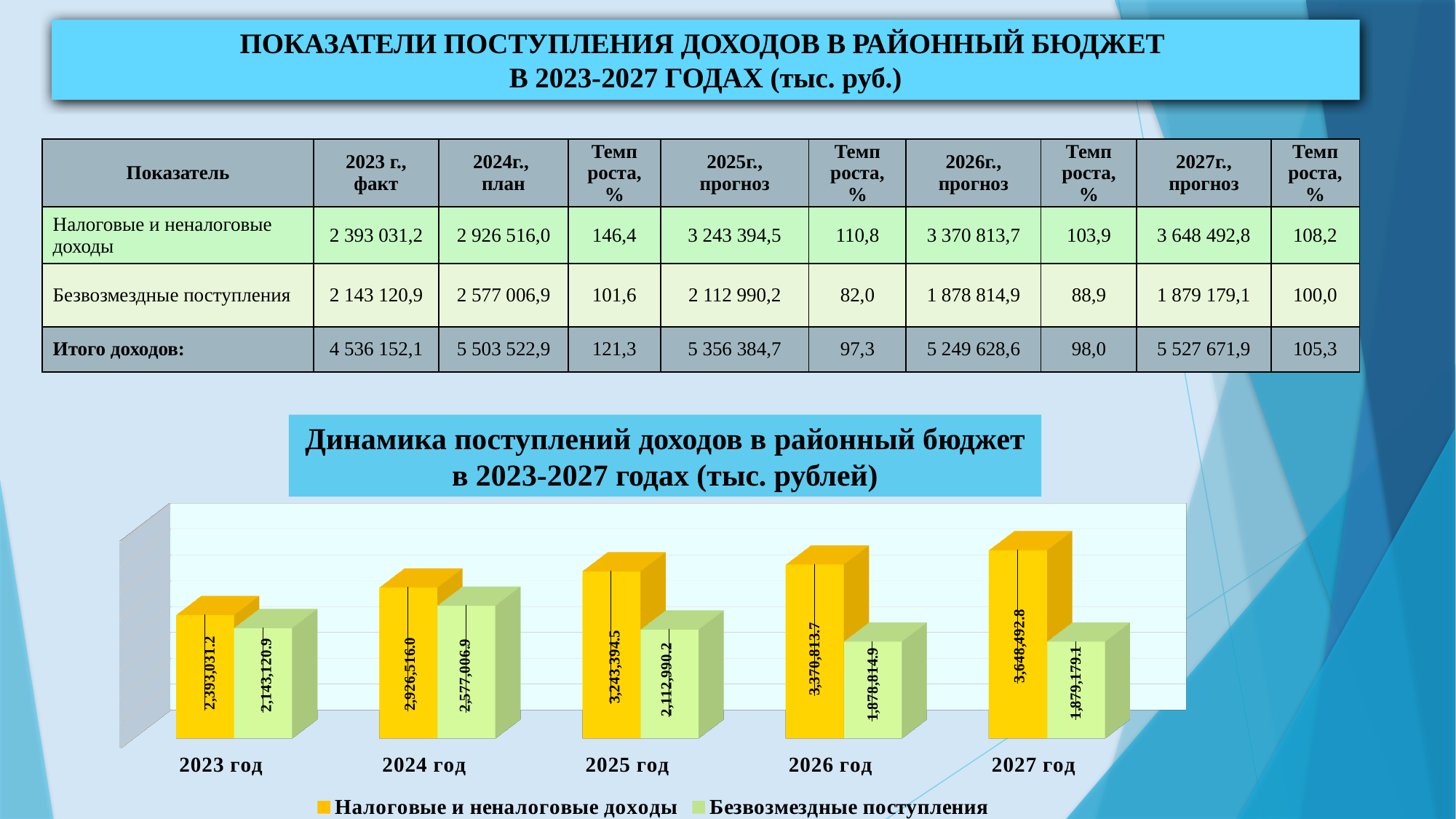
What is the value of Безвозмездные поступления for 2026 год in the chart? 1,878,814.9 What type of chart is shown on the slide? bar chart Does Налоговые и неналоговые доходы rise or fall from 2023 год to 2027 год in the chart? rise In which year is Налоговые и неналоговые доходы highest in the chart? 2027 год What colour are the bars for Безвозмездные поступления in the chart? light green What is the value of Безвозмездные поступления for 2025 год in the chart? 2,112,990.2 Which is larger in 2024 год: Налоговые и неналоговые доходы or Безвозмездные поступления? Налоговые и неналоговые доходы In which year is Безвозмездные поступления highest in the chart? 2024 год How many series does the chart legend list? 2 What is the value of Налоговые и неналоговые доходы for 2027 год in the chart? 3,648,492.8 What is the value of Налоговые и неналоговые доходы for 2023 год in the chart? 2,393,031.2 How many year categories are shown on the x axis of the chart? 5